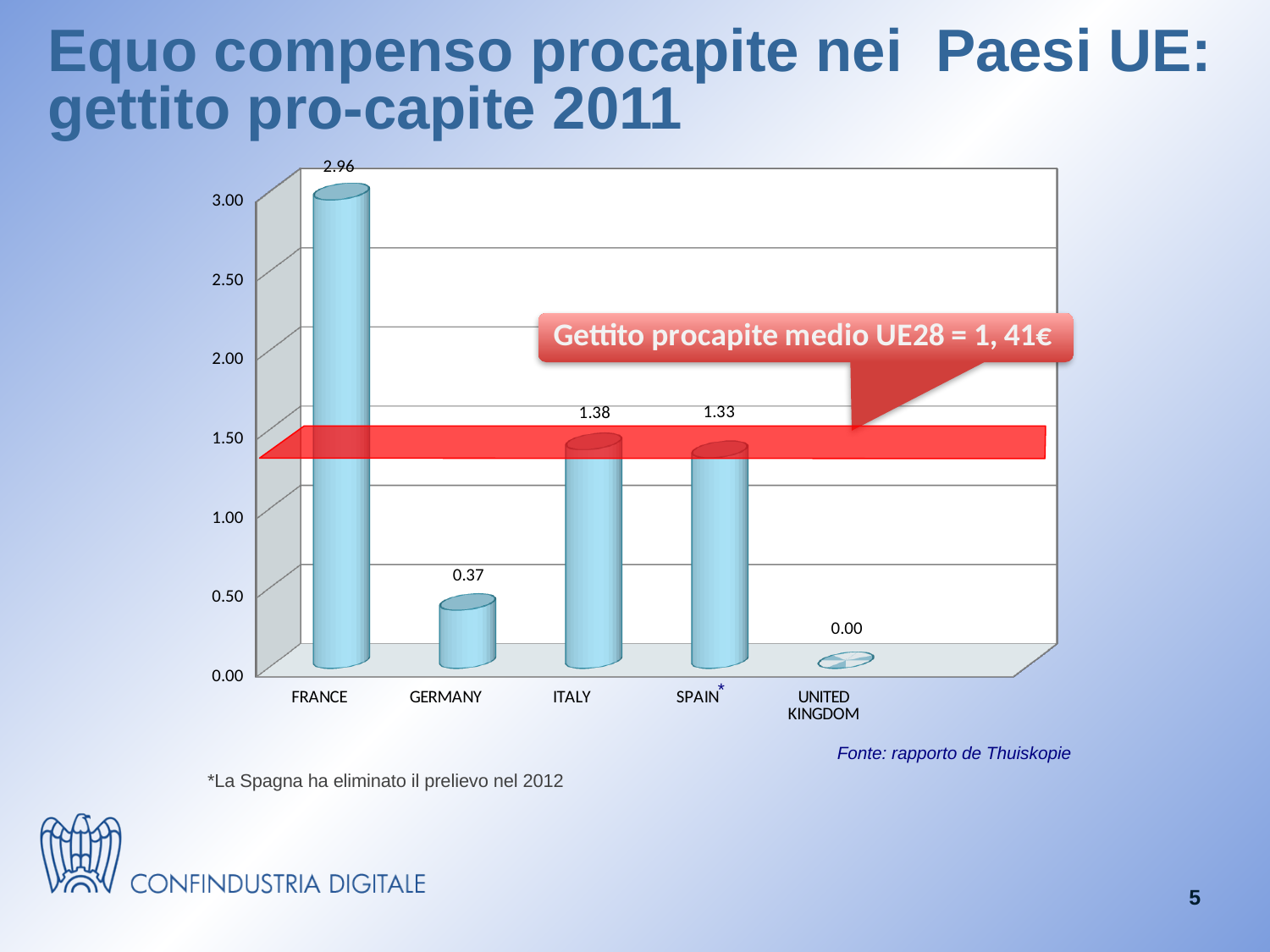
What is the value for Spain? 1.33 What is the difference between the values for France and Italy? 1.58 What is the value for Germany? 0.37 What kind of chart is shown on the slide? Bar chart What is the average per-capita revenue for the EU28 shown in the red callout? 1, 41€ What is the value for Italy? 1.38 How many countries are shown on the chart? 5 Which is larger, the value for Germany or the value for Spain? Spain What is the value for France? 2.96 Which country has the highest value? France What is the value for United Kingdom? 0.00 Which country has the lowest value? United Kingdom